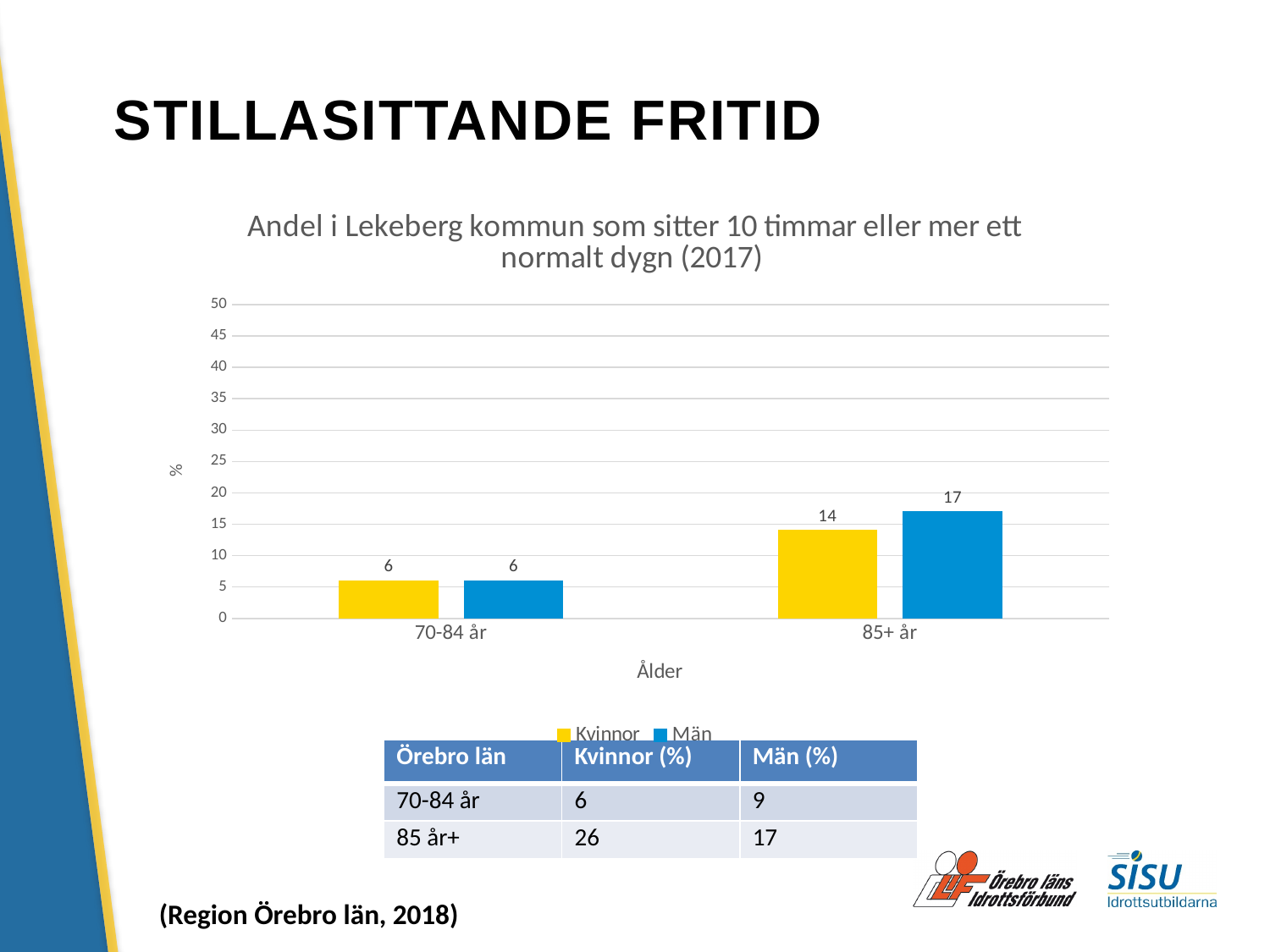
Is the value for Män in the 85+ år category greater or less than 20? less What is the difference between the Kvinnor values for 85+ år and 70-84 år? 8 What is the value for Kvinnor in the 70-84 år category? 6 What kind of chart is shown on the slide? bar chart How many series does the legend list? 2 What is the difference between the Män and Kvinnor values in the 85+ år category? 3 What is the value for Män in the 85+ år category? 17 Which age category has the lowest value for Kvinnor? 70-84 år How many age categories are shown on the x axis? 2 Which age category has the highest value for Män? 85+ år Which is larger in the 85+ år category, Kvinnor or Män? Män What is the value for Kvinnor in the 85+ år category? 14